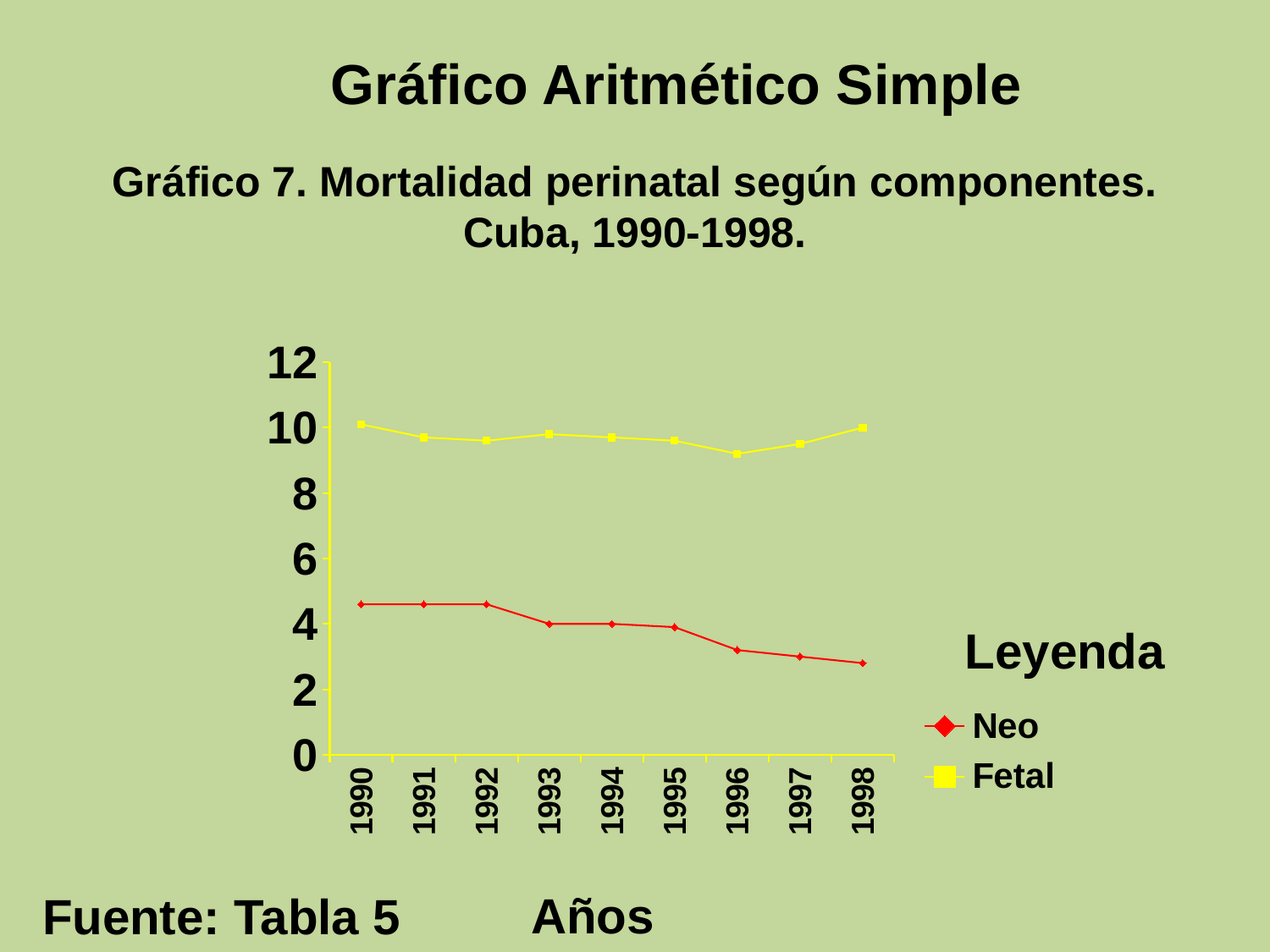
Which series has the higher value in 1990, Neo or Fetal? Fetal In which year is the Fetal series at its lowest? 1996 In which year is the Neo series at its lowest? 1998 Is the value for Fetal in 1998 greater or less than 8? greater How many series does the legend list? 2 How many years are plotted along the x axis? 9 Is the value for Neo in 1990 greater or less than 4? greater Does the Neo series rise or fall from 1990 to 1998? fall Is the value for Neo in 1998 greater or less than 4? less What label is given to the x axis of the chart? Años What kind of chart is shown on the slide? line chart